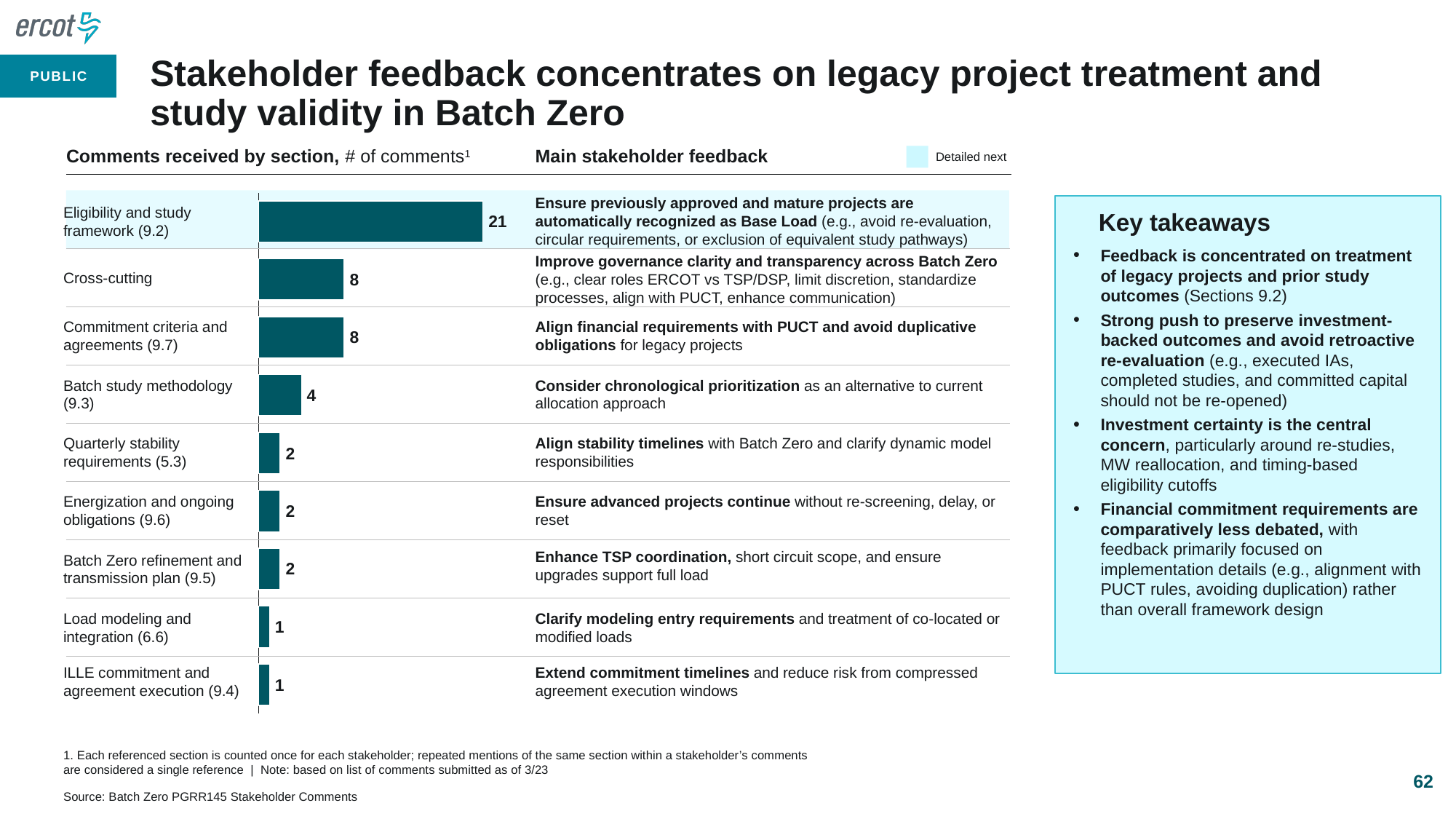
What is the unit of measurement stated in the chart's title? # of comments Which received more comments: Commitment criteria and agreements (9.7) or Batch study methodology (9.3)? Commitment criteria and agreements (9.7) How many sections are shown in the chart? 9 Which section received the most comments? Eligibility and study framework (9.2) How many sections received exactly 2 comments? 3 What is the difference in comments between Batch study methodology (9.3) and Quarterly stability requirements (5.3)? 2 How many comments were received for the Batch study methodology (9.3) section? 4 What kind of chart is used to show comments received by section? Bar chart How many comments were received for the Eligibility and study framework (9.2) section? 21 How many comments were received for Load modeling and integration (6.6)? 1 How many comments were received for the Cross-cutting section? 8 What is the difference in number of comments between Eligibility and study framework (9.2) and Cross-cutting? 13